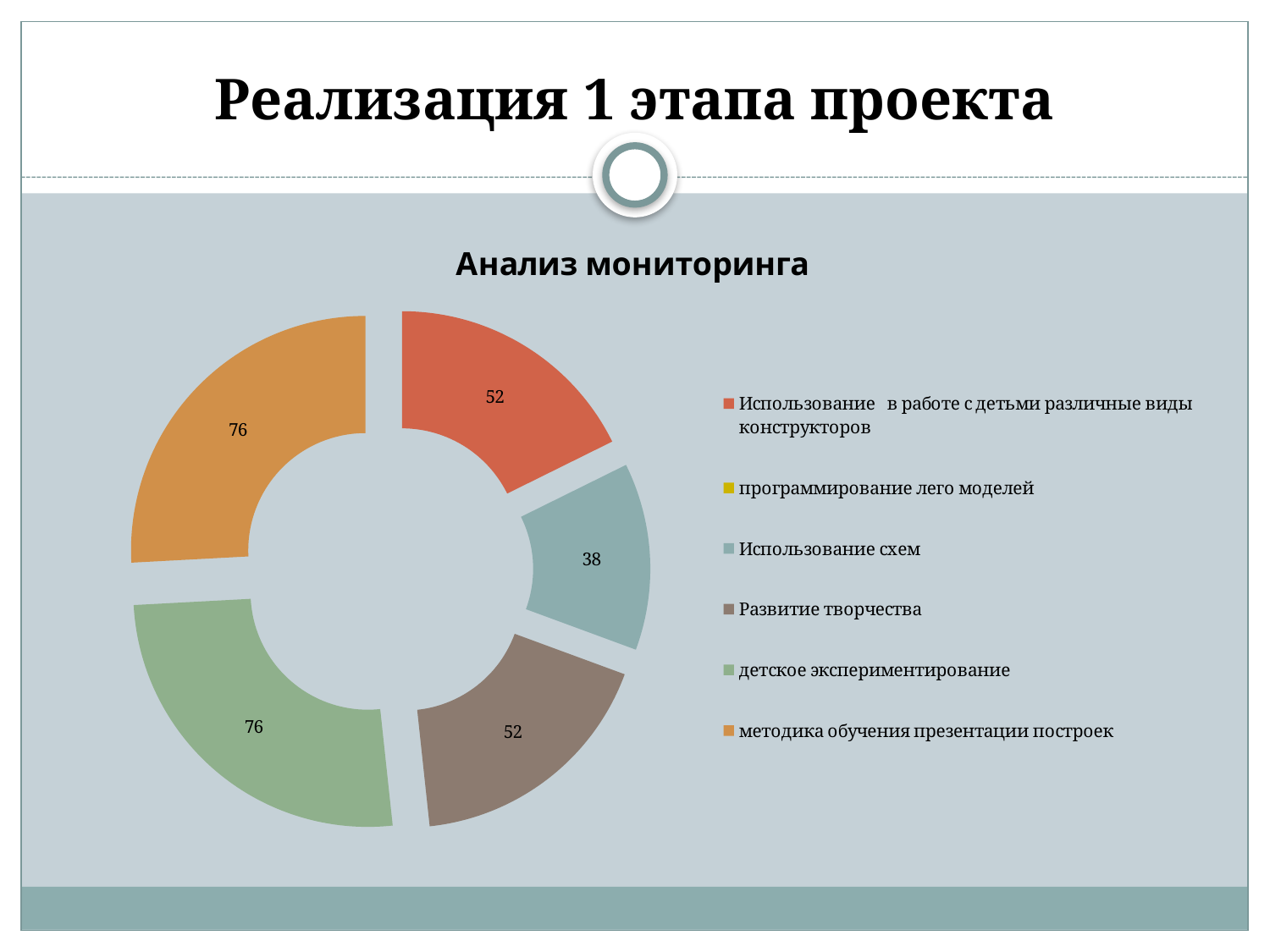
What is the value for детское экспериментирование? 76 What is the difference between the values for Развитие творчества and Использование схем? 14 Which is larger: the value for детское экспериментирование or the value for Использование схем? детское экспериментирование What is the value for Использование схем? 38 What kind of chart is shown on the slide? Doughnut (pie) chart What is the difference between the values for детское экспериментирование and Использование схем? 38 How many entries does the chart legend list? 6 What is the value for Развитие творчества? 52 What is the title of the chart? Анализ мониторинга What is the value for Использование в работе с детьми различные виды конструкторов? 52 What is the value for методика обучения презентации построек? 76